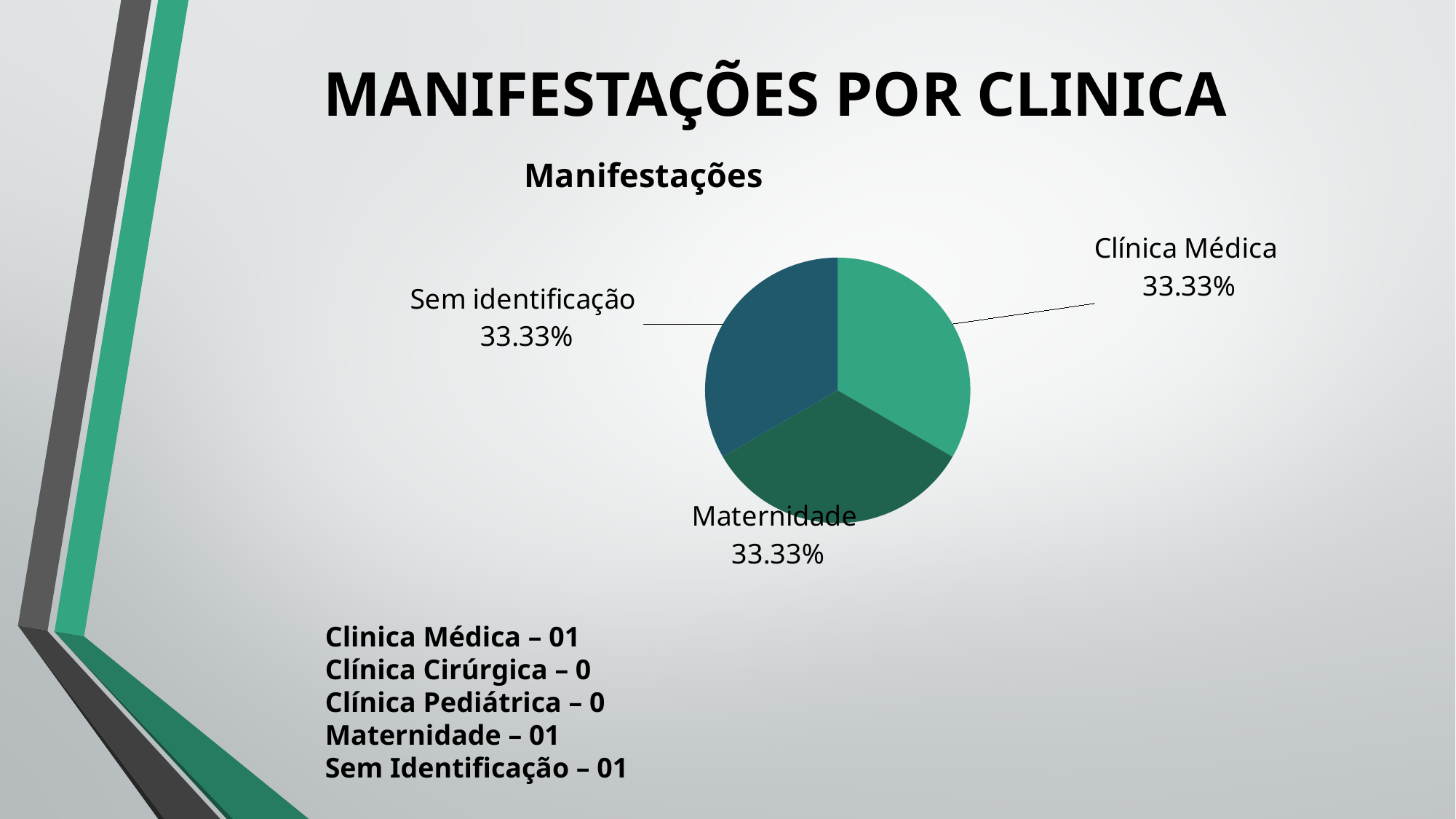
What share of the pie does Sem identificação represent? 33.33% How many slices does the pie chart have? 3 What share of the pie does Maternidade represent? 33.33% What share of the pie does Clínica Médica represent? 33.33% Do all three slices of the pie chart have the same percentage? Yes Which slice is labelled at the bottom of the pie chart? Maternidade What is the difference between the Clínica Médica share and the Sem identificação share? 0% What is the title of the chart? Manifestações What is the value labelled for the Maternidade slice? 33.33% What kind of chart is shown on the slide? pie chart